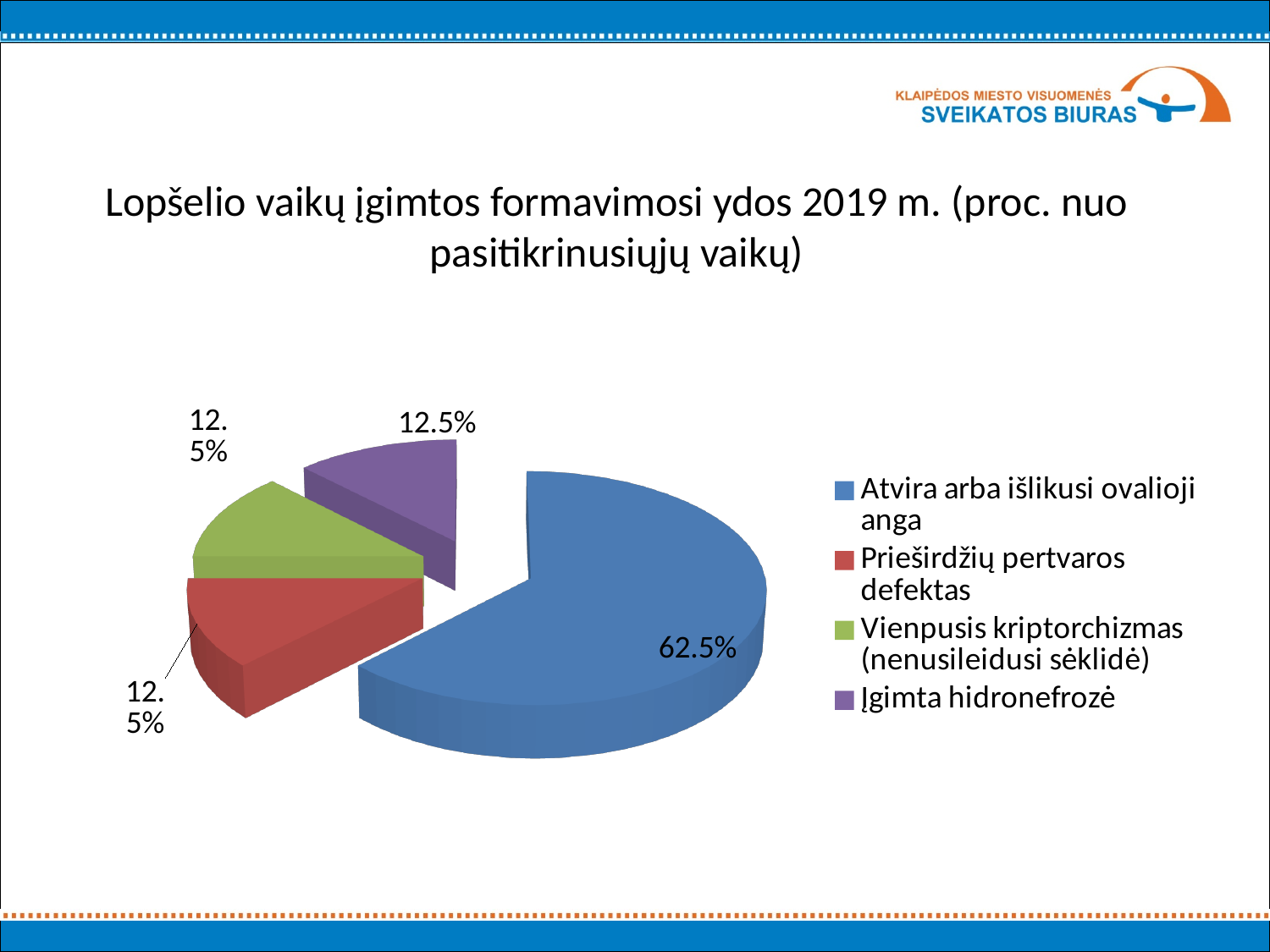
Which is larger, the share for "Atvira arba išlikusi ovalioji anga" or the share for "Prieširdžių pertvaros defektas"? Atvira arba išlikusi ovalioji anga Which category has the largest share of the pie? Atvira arba išlikusi ovalioji anga What type of chart is shown on the slide? pie chart What colour is the slice for "Įgimta hidronefrozė"? purple What is the value for "Prieširdžių pertvaros defektas"? 12.5% What is the value for "Vienpusis kriptorchizmas (nenusileidusi sėklidė)"? 12.5% How many entries does the legend list? 4 What is the value for "Atvira arba išlikusi ovalioji anga"? 62.5% What is the title of the chart? Lopšelio vaikų įgimtos formavimosi ydos 2019 m. (proc. nuo pasitikrinusiųjų vaikų) What is the difference in percentage points between "Atvira arba išlikusi ovalioji anga" and "Įgimta hidronefrozė"? 50 percentage points How many slices does the pie chart have? 4 What is the value for "Įgimta hidronefrozė"? 12.5%